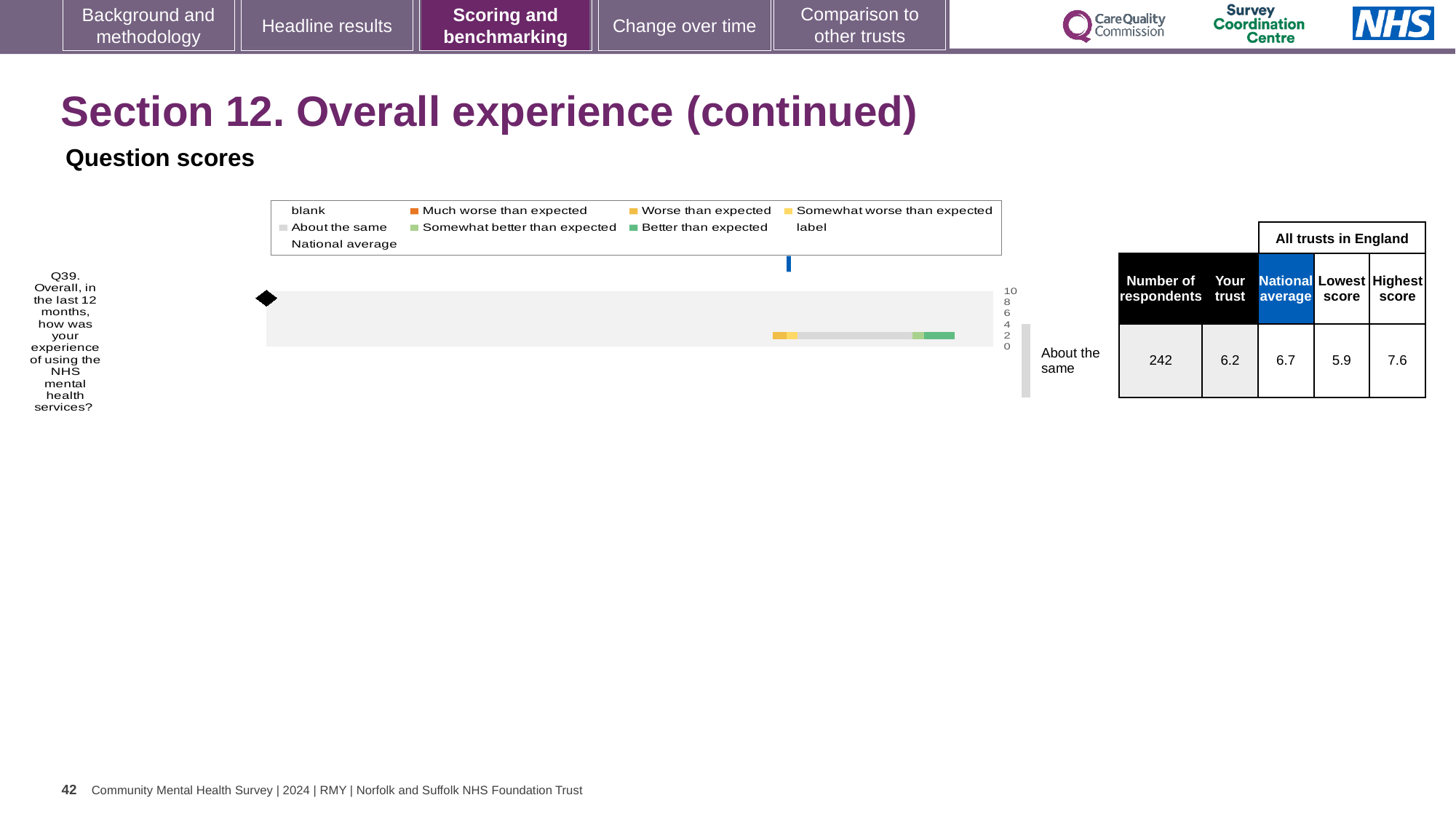
How many survey questions are plotted on the chart? 1 What benchmark category label is shown next to the Q39 bar? About the same What is the national average score for Q39? 6.7 Which question number is plotted on the chart? Q39 What is the 'Your trust' score for Q39? 6.2 What kind of chart is used to show the Q39 score? bar chart How many respondents answered Q39? 242 Is the 'Your trust' score for Q39 greater or less than 8 on the chart axis? less What is the highest score among all trusts in England for Q39? 7.6 For Q39, what is the difference between the highest score and the lowest score among all trusts in England? 1.7 For Q39, which is larger: the 'Your trust' score or the national average? National average What is the lowest score among all trusts in England for Q39? 5.9